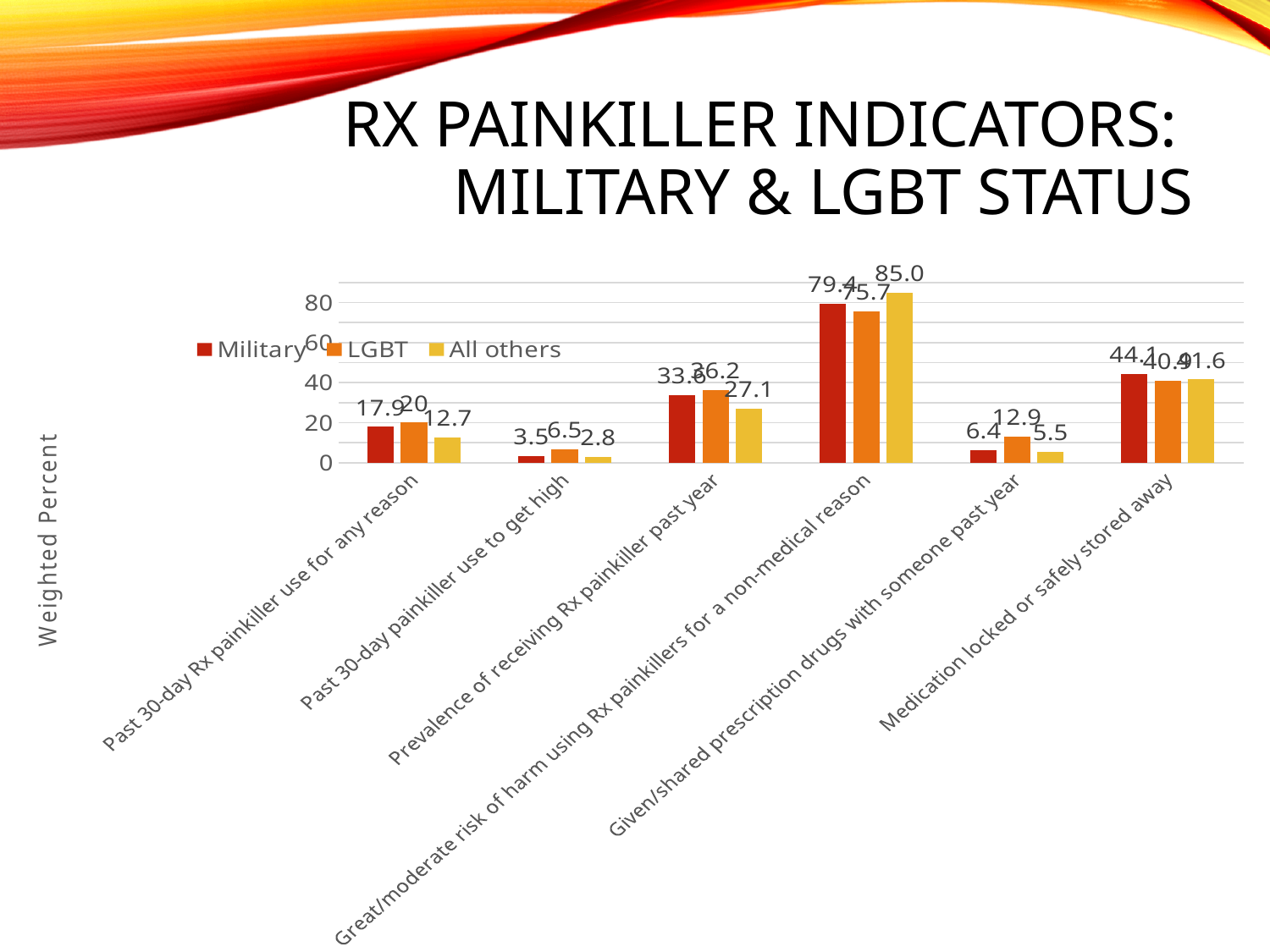
For 'Given/shared prescription drugs with someone past year', which is larger: the Military value or the LGBT value? LGBT Which category has the lowest All others value? Past 30-day painkiller use to get high How many categories are shown on the x axis? 6 Which category has the highest Military value? Great/moderate risk of harm using Rx painkillers for a non-medical reason What kind of chart is shown on the slide? Bar chart What is the All others value for 'Past 30-day painkiller use to get high'? 2.8 What is the LGBT value for 'Given/shared prescription drugs with someone past year'? 12.9 Is the Military value for 'Prevalence of receiving Rx painkiller past year' greater or less than 20? greater How many series does the legend list? 3 In the 'Great/moderate risk of harm' category, what is the difference between the All others value and the Military value? 5.6 What is the Military value for 'Past 30-day Rx painkiller use for any reason'? 17.9 What is the value for All others in the 'Great/moderate risk of harm using Rx painkillers for a non-medical reason' category? 85.0